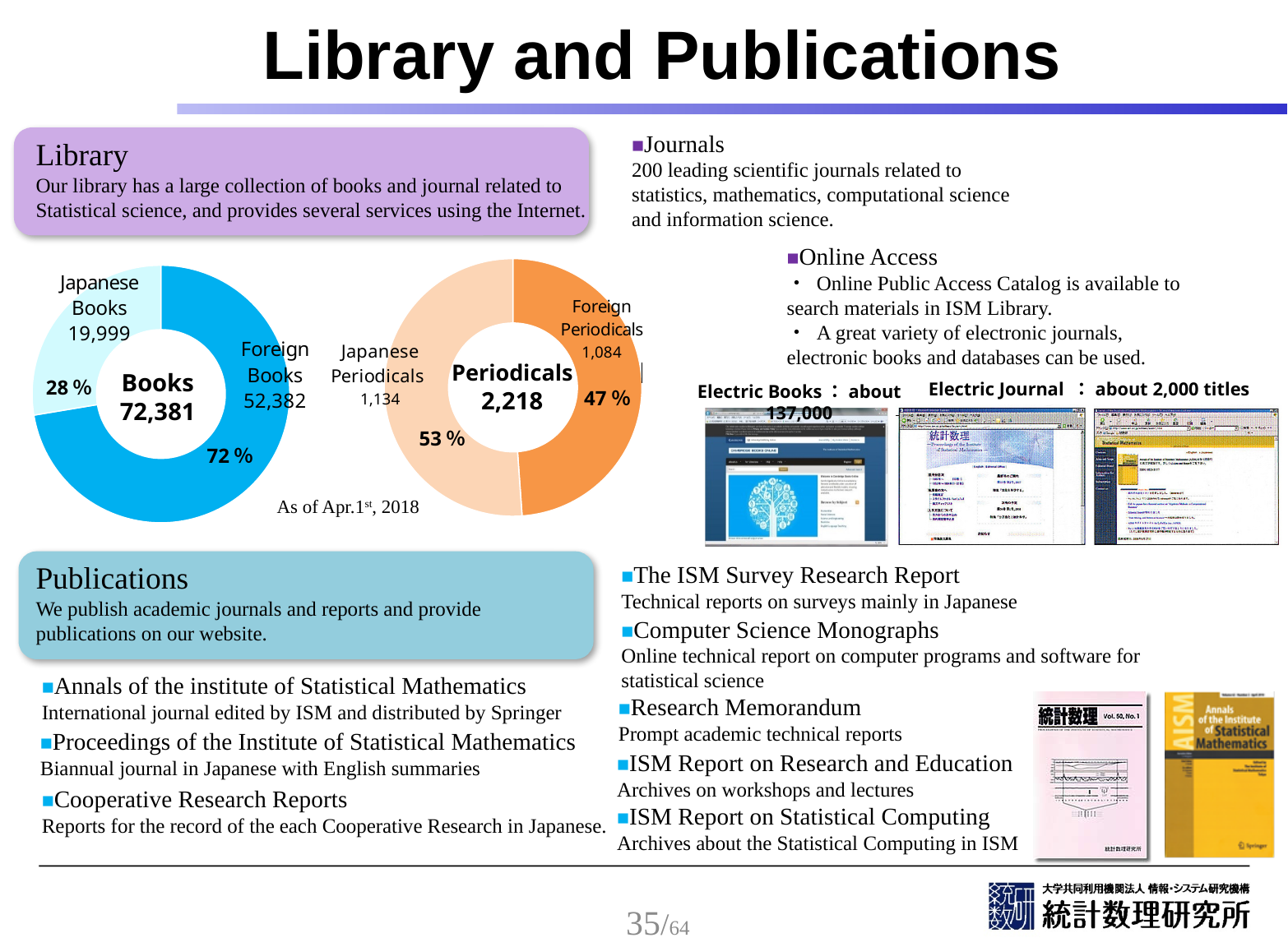
On the Periodicals chart, what is the value for Japanese Periodicals? 1,134 On the Books chart, what percentage share do Foreign Books have? 72 % What kind of chart is the Books chart? Donut (pie) chart On the Books chart, what is the value for Foreign Books? 52,382 On the Periodicals chart, what percentage share do Japanese Periodicals have? 53 % On the Books chart, what is the difference between Foreign Books and Japanese Books? 32,383 On the Periodicals chart, what is the value for Foreign Periodicals? 1,084 On the Periodicals chart, what total is shown in the centre? 2,218 On the Books chart, what total is shown in the centre? 72,381 On the Books chart, which category is the largest? Foreign Books On the Books chart, what is the value for Japanese Books? 19,999 On the Periodicals chart, what is the difference between Japanese Periodicals and Foreign Periodicals? 50